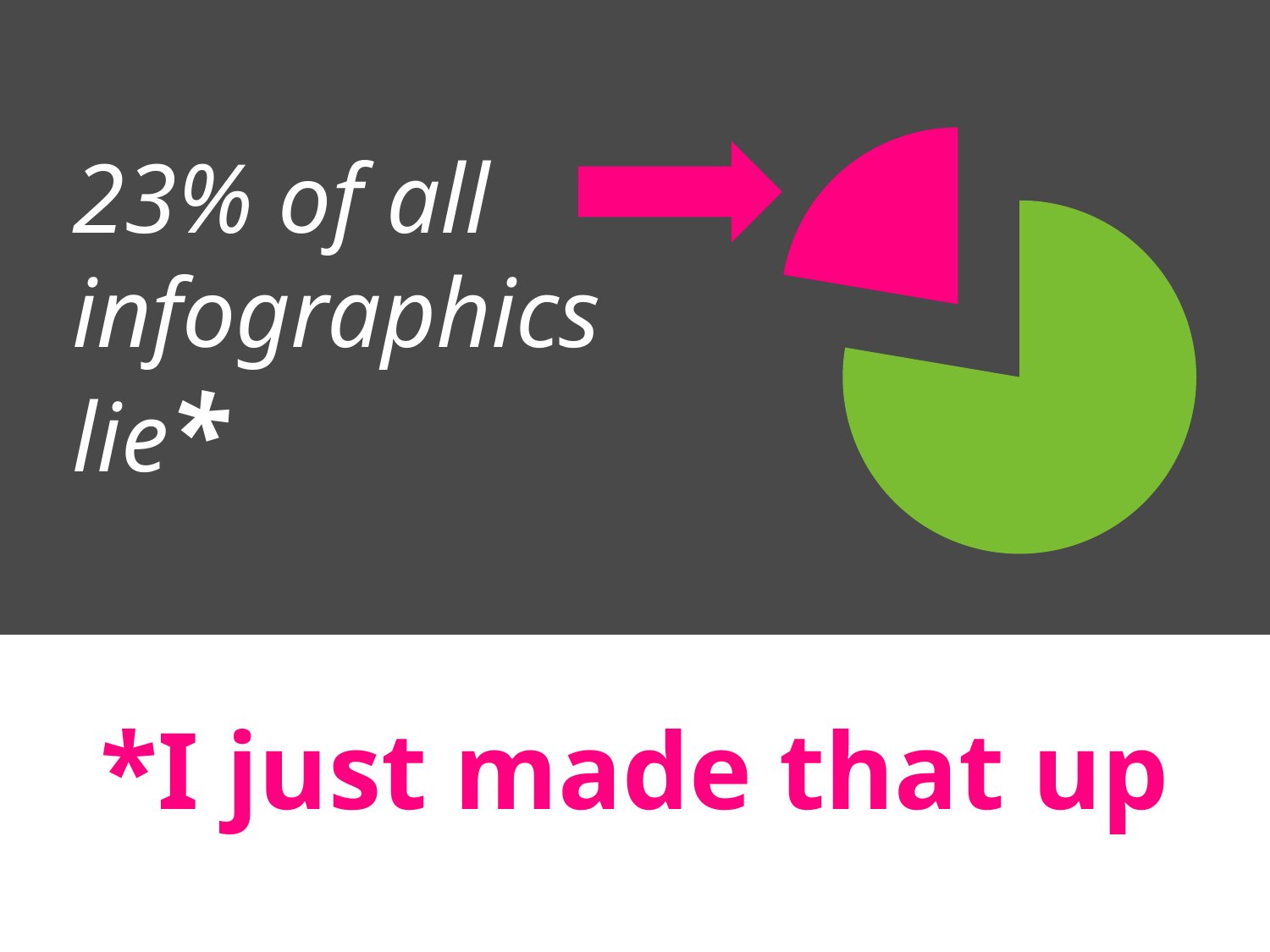
Does the green slice cover more or less than half of the pie? more What percentage does the pink slice of the pie chart represent? 23% How many slices does the pie chart have? 2 What kind of chart is shown on the slide? pie chart Which slice of the pie chart is the largest? the green slice Which slice of the pie chart is pulled out (exploded) from the rest of the pie? the pink slice What colour is the slice that the arrow from the text '23% of all infographics lie' points to? pink Which slice of the pie chart is the smallest? the pink slice What share of the pie does the slice the arrow points to represent? 23% Which slice is larger, the pink slice or the green slice? the green slice